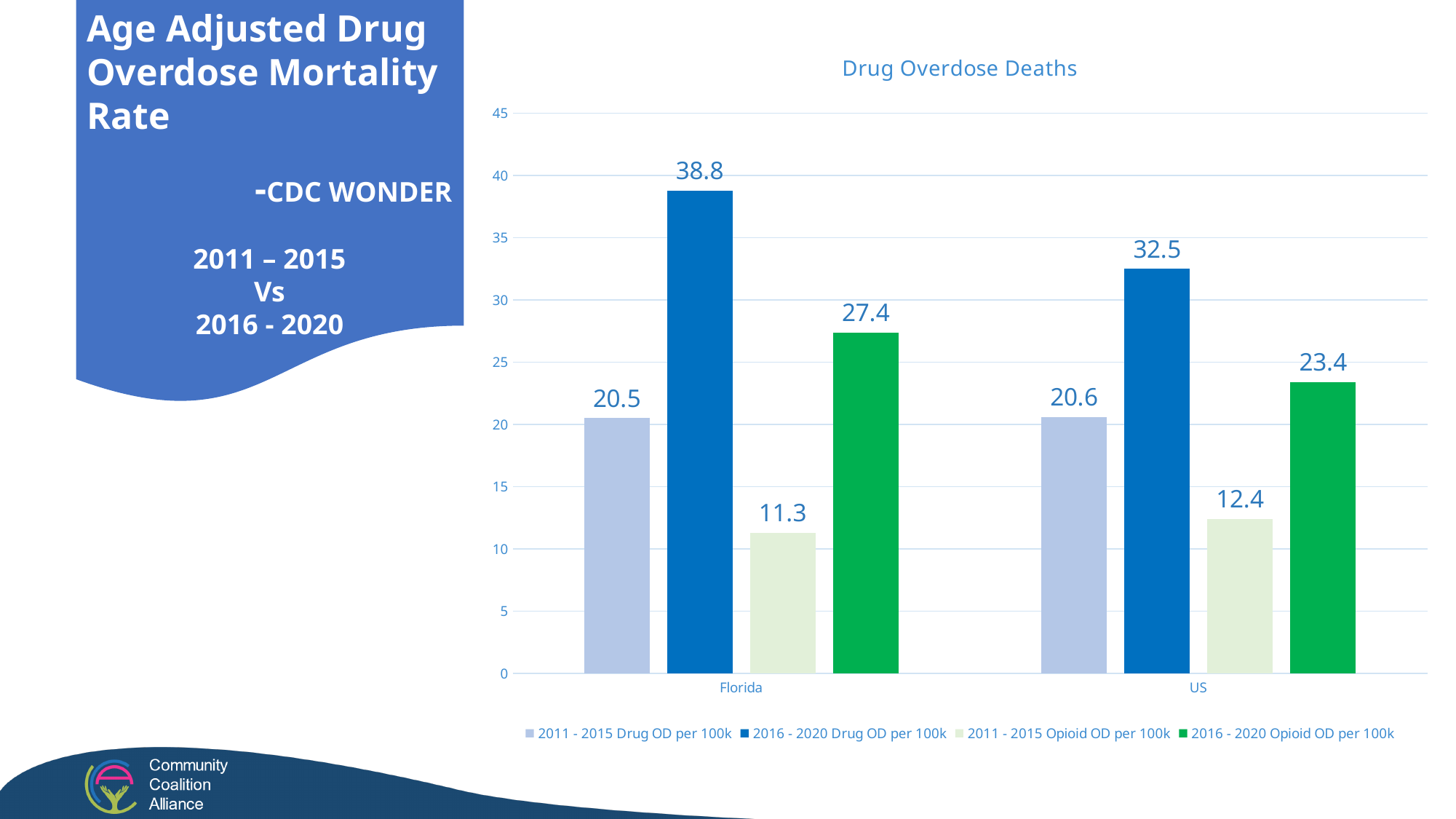
What is the 2016 - 2020 Drug OD per 100k value for Florida? 38.8 How many categories are shown on the x axis? 2 What is the 2016 - 2020 Opioid OD per 100k value for Florida? 27.4 What is the difference between the 2016 - 2020 Drug OD per 100k values for Florida and the US? 6.3 Which series has the lowest value for Florida? 2011 - 2015 Opioid OD per 100k What is the difference between the 2011 - 2015 and 2016 - 2020 Opioid OD per 100k values for the US? 11.0 Which is larger: the 2016 - 2020 Opioid OD per 100k value for Florida or for the US? Florida What type of chart is shown on the slide? Bar chart Is the 2011 - 2015 Drug OD per 100k value for the US greater or less than 25? less What is the 2011 - 2015 Opioid OD per 100k value for the US? 12.4 How many series does the legend list? 4 Which category has the highest 2016 - 2020 Drug OD per 100k value? Florida